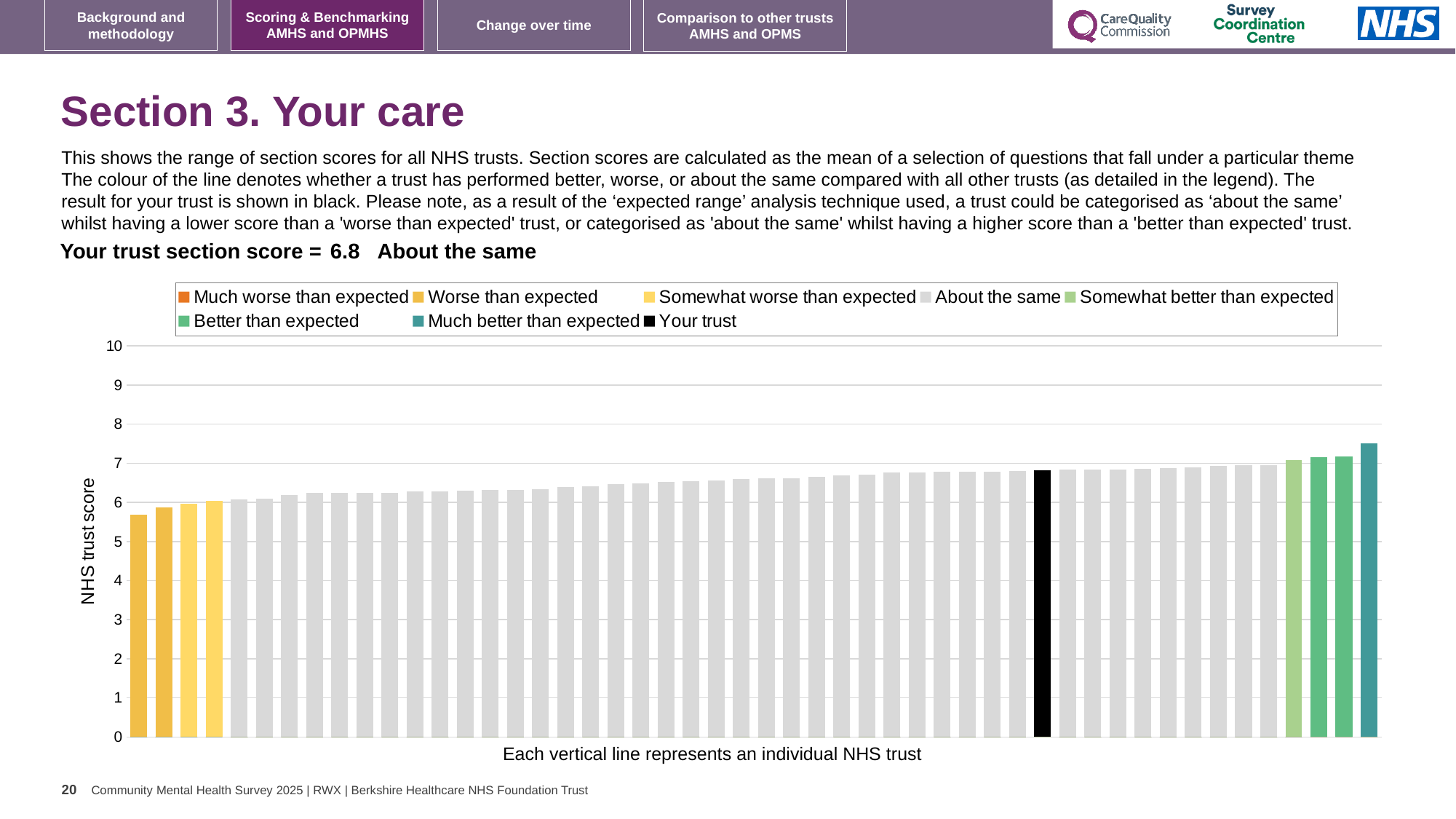
What is the label of the y axis? NHS trust score Which legend category does the highest bar belong to? Much better than expected How many entries does the chart legend list? 8 What is the section score for your trust shown on the slide? 6.8 Do the bar values rise or fall from left to right along the x axis? rise How many bars are coloured as 'Better than expected' (green)? 2 Is the value for the black 'Your trust' bar greater or less than 7? less Which legend category does the lowest bar belong to? Worse than expected Is the value for the tallest bar (Much better than expected) greater or less than 7? greater What kind of chart is shown on the slide? bar chart Is the value for the leftmost (lowest) bar greater or less than 6? less What colour is used for the 'Your trust' bar? black